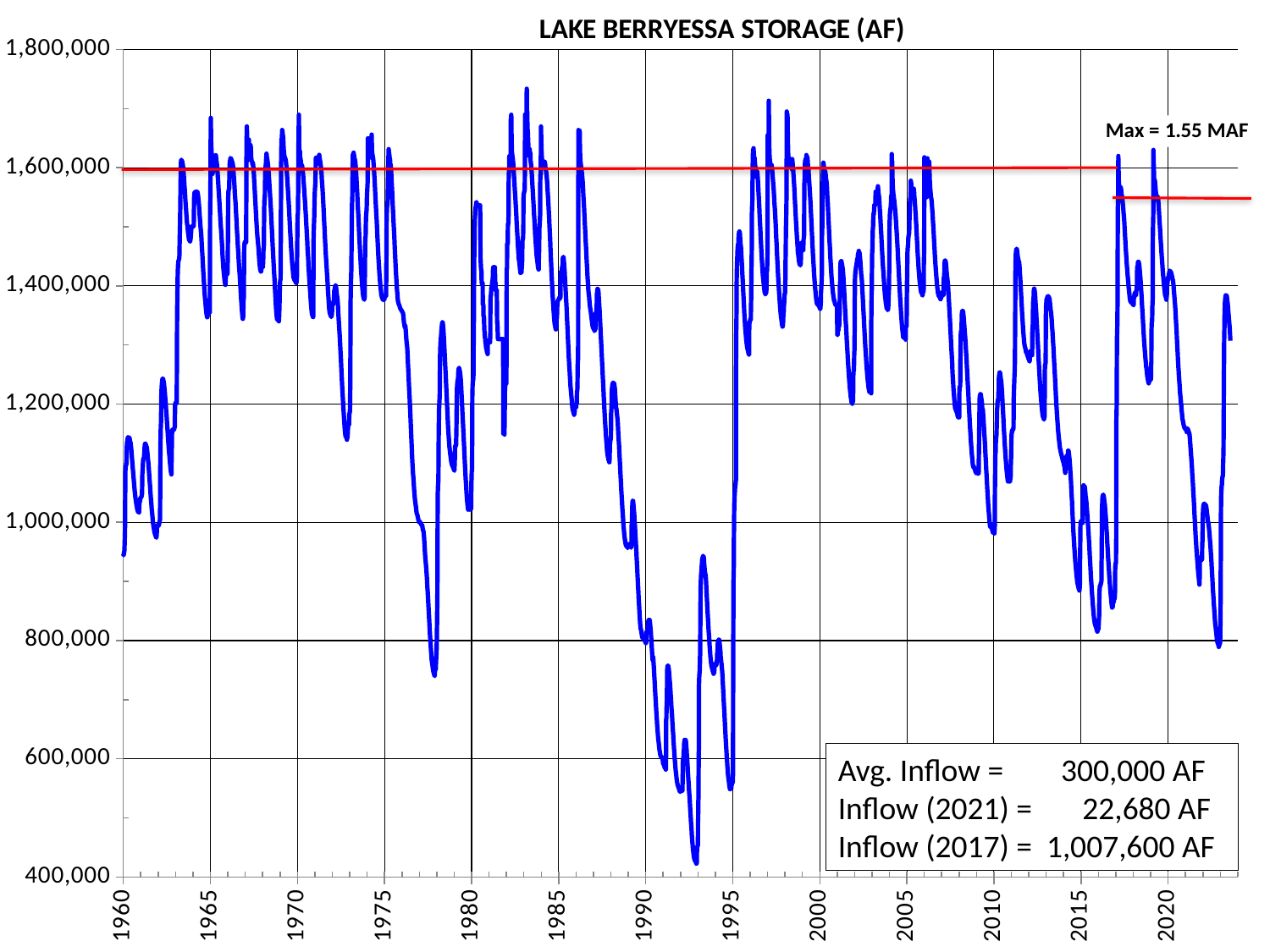
Does the storage generally rise or fall between 1985 and 1993? fall What kind of chart is shown on the slide? line chart What is the title of the chart? LAKE BERRYESSA STORAGE (AF) Is the lowest storage value reached around 1993 greater or less than 600,000? less By how much did the inflow in 2017 exceed the inflow in 2021, using the values in the text box? 984,920 AF Is the peak storage value reached around 1983 greater or less than 1,600,000? greater Which low point is lower: the dip around 1977 or the dip around 1993? the dip around 1993 What maximum storage value is labelled next to the red line on the right of the chart? Max = 1.55 MAF Is the storage value at the start of the series in 1960 greater or less than 1,000,000? less According to the text box on the chart, what was the inflow in 2021? 22,680 AF According to the text box on the chart, what was the inflow in 2017? 1,007,600 AF According to the text box on the chart, what is the average inflow? 300,000 AF